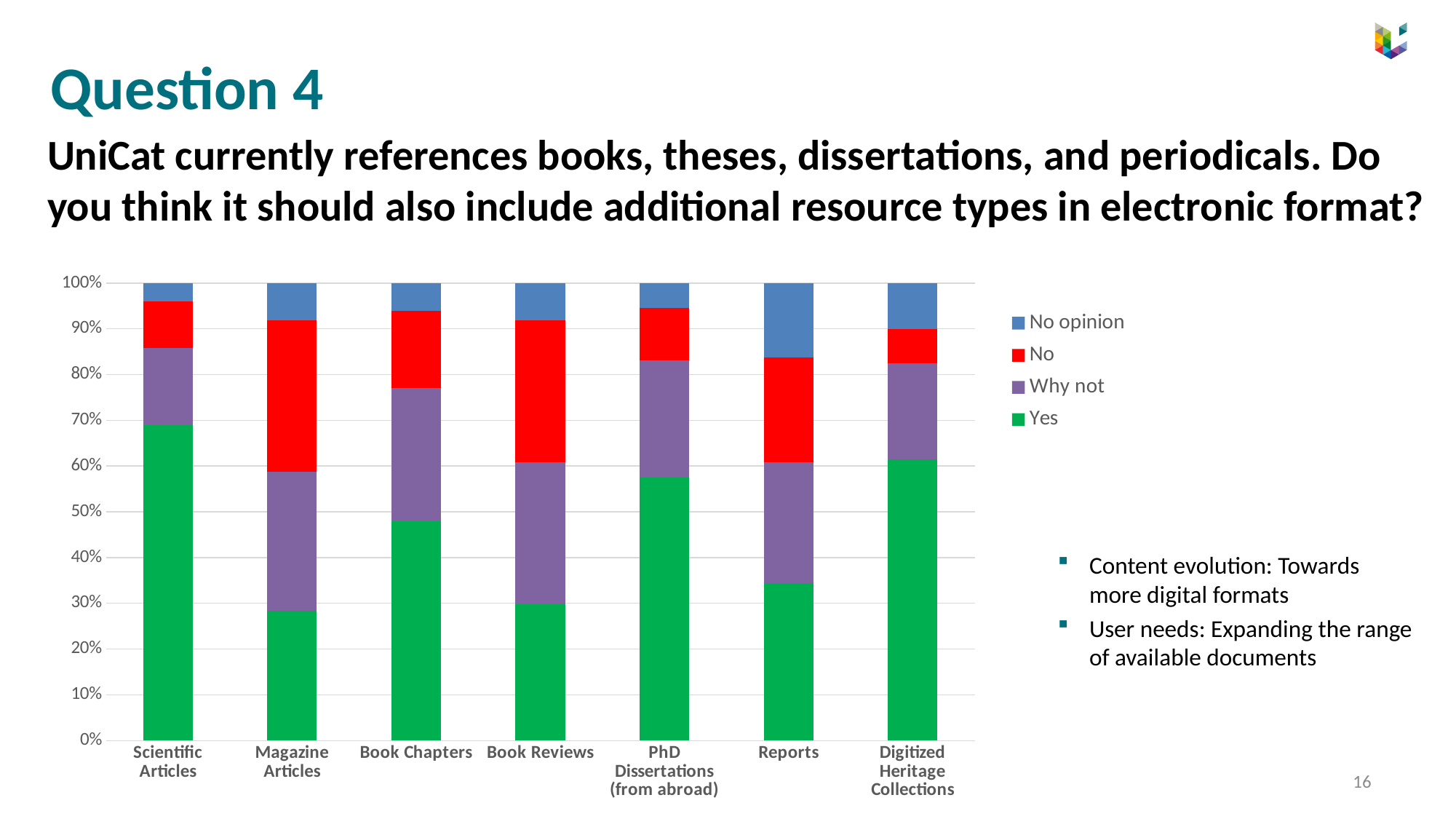
Which category has the largest 'Yes' share in the chart? Scientific Articles How many series does the chart legend list? 4 What does each stacked bar in the chart total? 100% Is the 'Yes' share for Scientific Articles greater or less than 60%? greater Which category has the largest 'No opinion' share in the chart? Reports What kind of chart is shown on the slide? Stacked bar chart Which colour represents the 'Yes' series in the chart legend? Green Is the 'Yes' share for Digitized Heritage Collections greater or less than 50%? greater Which has a larger 'Yes' share: Book Chapters or Magazine Articles? Book Chapters Is the 'Yes' share for Reports greater or less than 40%? less How many resource-type categories are shown on the x axis of the chart? 7